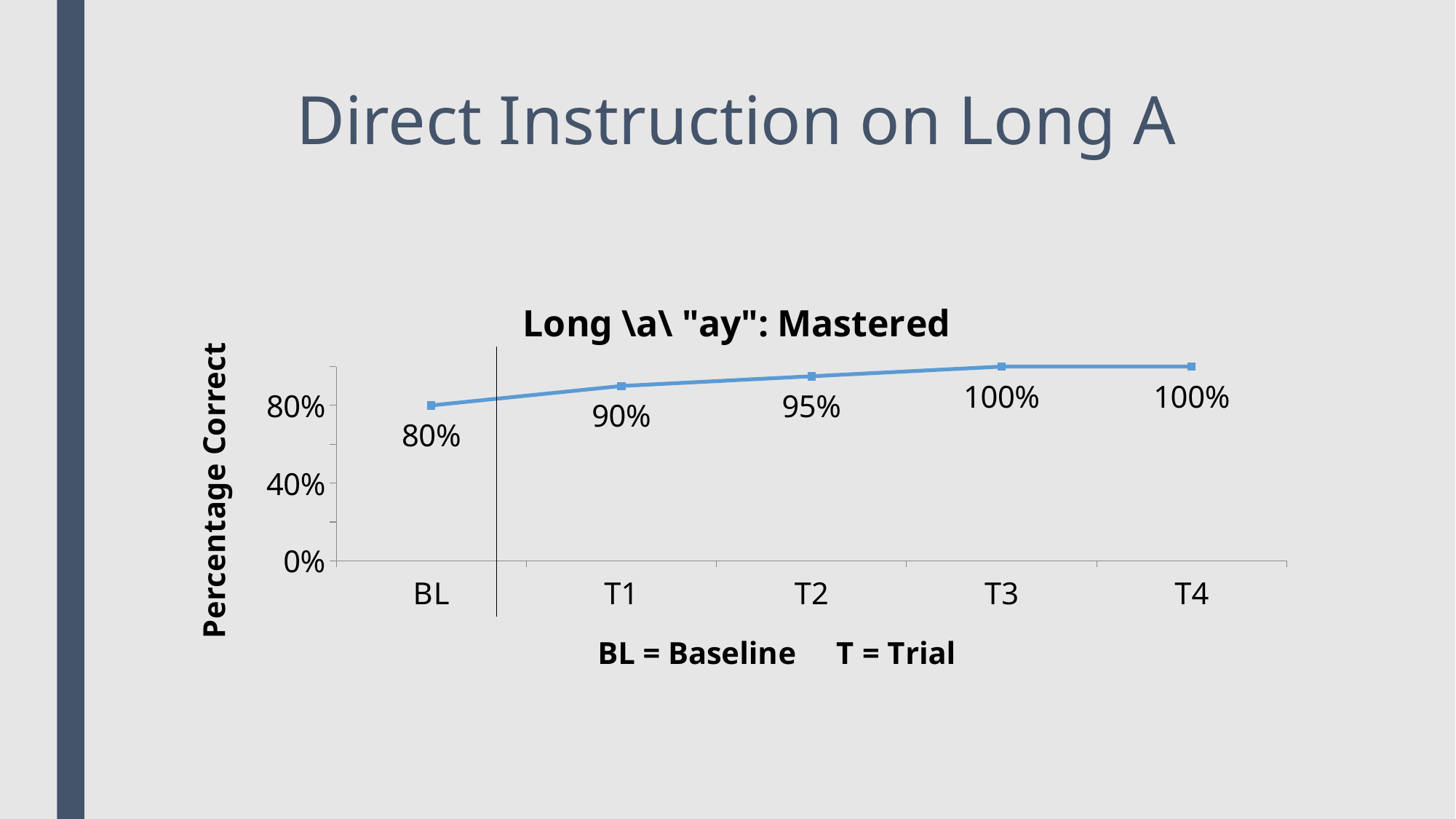
How many data points are plotted on the chart? 5 What is the difference in percentage correct between T2 and T1? 5% What is the difference in percentage correct between T3 and BL? 20% What is the title of the chart? Long \a\ "ay": Mastered What is the percentage correct at BL? 80% Do the values rise or fall from BL to T4? rise Which has a higher percentage correct, T1 or T2? T2 What is the percentage correct at T4? 100% What kind of chart is shown on the slide? line chart Is the value at T1 greater or less than 40%? greater Which point has the lowest percentage correct? BL What is the percentage correct at T2? 95%